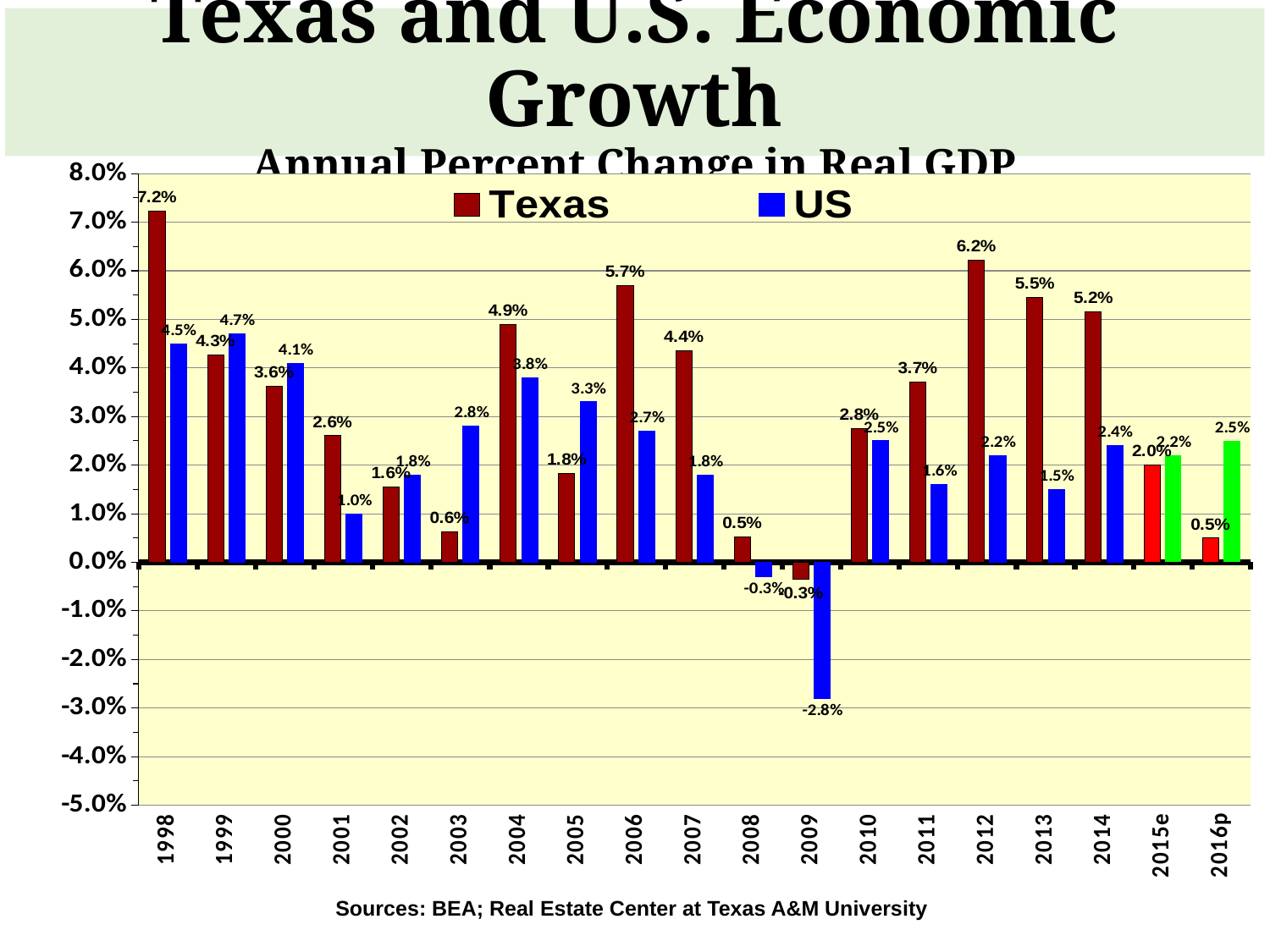
Which was larger in 2014, the Texas value or the US value? Texas What was the US annual percent change in real GDP in 2009? -2.8% In which year did Texas have its highest annual percent change in real GDP? 1998 What kind of chart is shown on the slide? Bar chart What is the Texas value shown for 2006? 5.7% What are the two series named in the legend? Texas and US Which was larger in 2003, the Texas value or the US value? US How many series does the legend list? 2 How many years (categories) are shown on the x axis? 19 What was Texas's annual percent change in real GDP in 2012? 6.2% What is the difference between the Texas and US values in 2013? 4.0% In which year was the US annual percent change in real GDP lowest? 2009